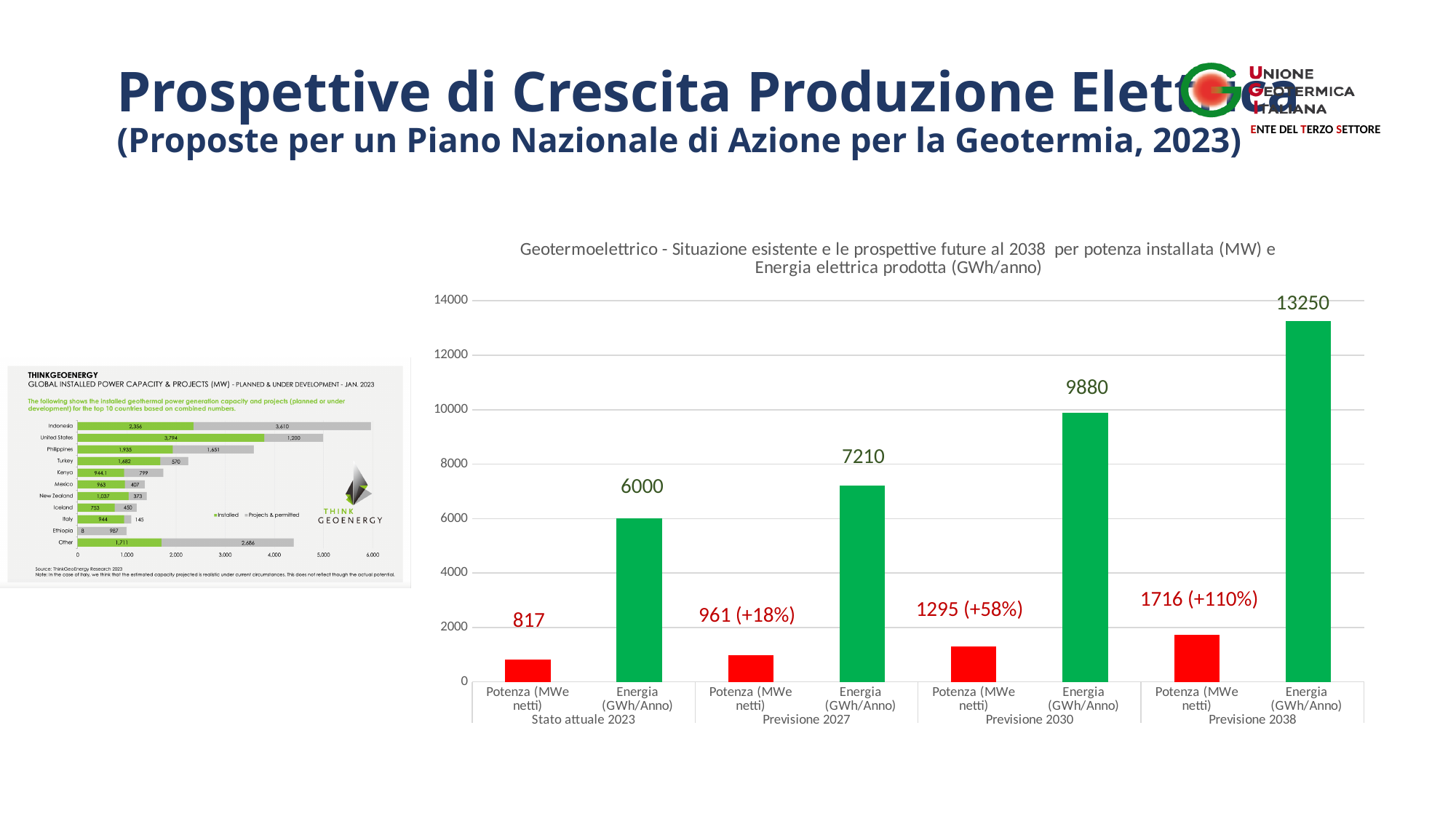
In the right-hand chart, is the Energia (GWh/Anno) value for Previsione 2027 greater or less than 8000? less In the right-hand chart, what is the difference between the Energia (GWh/Anno) values for Previsione 2038 and Stato attuale 2023? 7250 In the right-hand chart, which period has the highest Energia (GWh/Anno) value? Previsione 2038 In the right-hand chart, do the Energia (GWh/Anno) values rise or fall from Stato attuale 2023 to Previsione 2038? rise In the right-hand chart, what label is printed above the Potenza (MWe netti) bar for Previsione 2027? 961 (+18%) In the right-hand chart, what is the Energia (GWh/Anno) value for Previsione 2030? 9880 In the right-hand chart, what is the Potenza (MWe netti) value for Stato attuale 2023? 817 In the right-hand chart, which period has the lowest Potenza (MWe netti) value? Stato attuale 2023 In the right-hand chart, how many periods (category groups) are shown on the x axis? 4 In the right-hand chart, what is the Energia (GWh/Anno) value for Previsione 2038? 13250 What kind of chart is the right-hand chart? bar chart In the right-hand chart, what is the difference between the Energia (GWh/Anno) values for Previsione 2030 and Previsione 2027? 2670